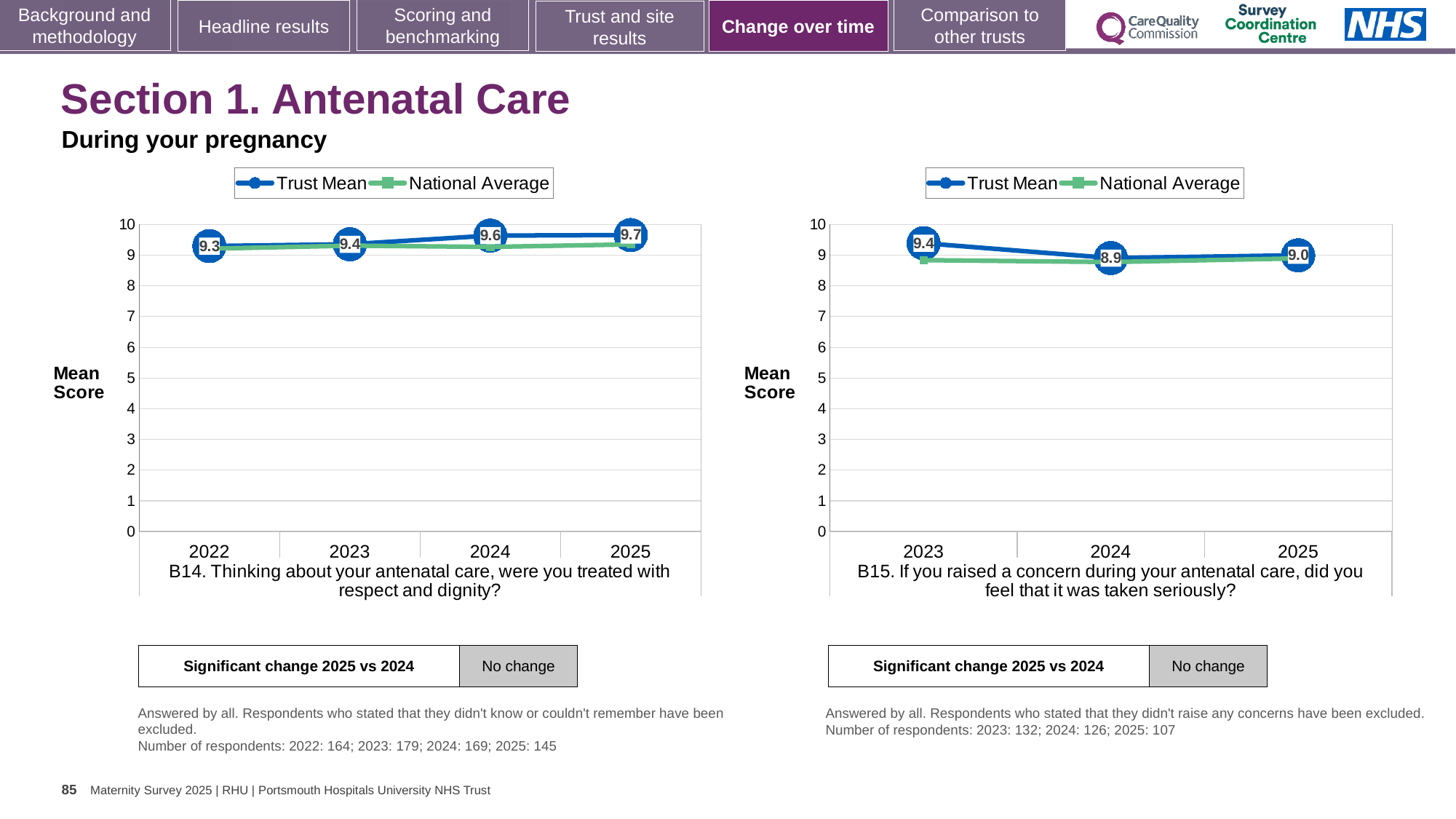
In the left chart (B14), which year has the lowest Trust Mean score? 2022 In the left chart (B14), is the National Average value for 2022 greater or less than 8? greater What type of chart is the left chart (B14)? Line chart In the left chart (B14), what is the Trust Mean score for 2022? 9.3 In the right chart (B15), what is the Trust Mean score for 2024? 8.9 In the left chart (B14), what is the Trust Mean score for 2025? 9.7 How many years are shown on the x axis of the right chart (B15)? 3 In the right chart (B15), which year has the highest Trust Mean score? 2023 In the left chart (B14), what is the difference between the Trust Mean scores for 2025 and 2022? 0.4 In the right chart (B15), is the Trust Mean score for 2023 larger or smaller than the score for 2025? larger How many series does the legend of the left chart (B14) list? 2 In the left chart (B14), does the Trust Mean rise or fall from 2022 to 2025? Rise